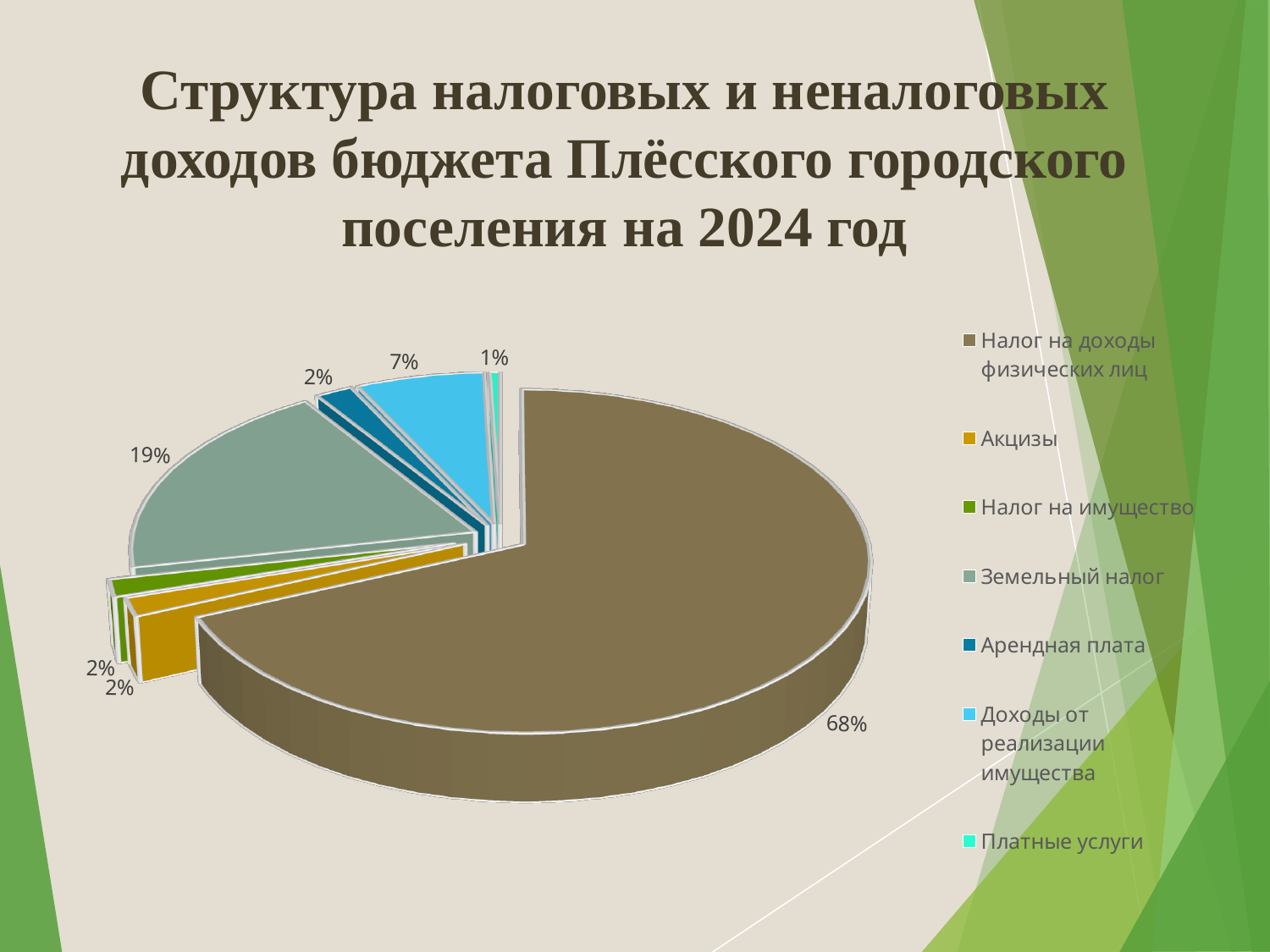
Which category has the smallest slice of the pie? Платные услуги What share of the pie does Доходы от реализации имущества represent? 7% What share of the pie does Платные услуги represent? 1% What kind of chart is shown on the slide? Pie chart Which is larger, the share for Земельный налог or the share for Доходы от реализации имущества? Земельный налог What share of the pie does Арендная плата represent? 2% Which category has the largest slice of the pie? Налог на доходы физических лиц What is the combined share of Земельный налог and Доходы от реализации имущества? 26% What is the difference in percentage points between Налог на доходы физических лиц and Земельный налог? 49 How many categories does the legend list? 7